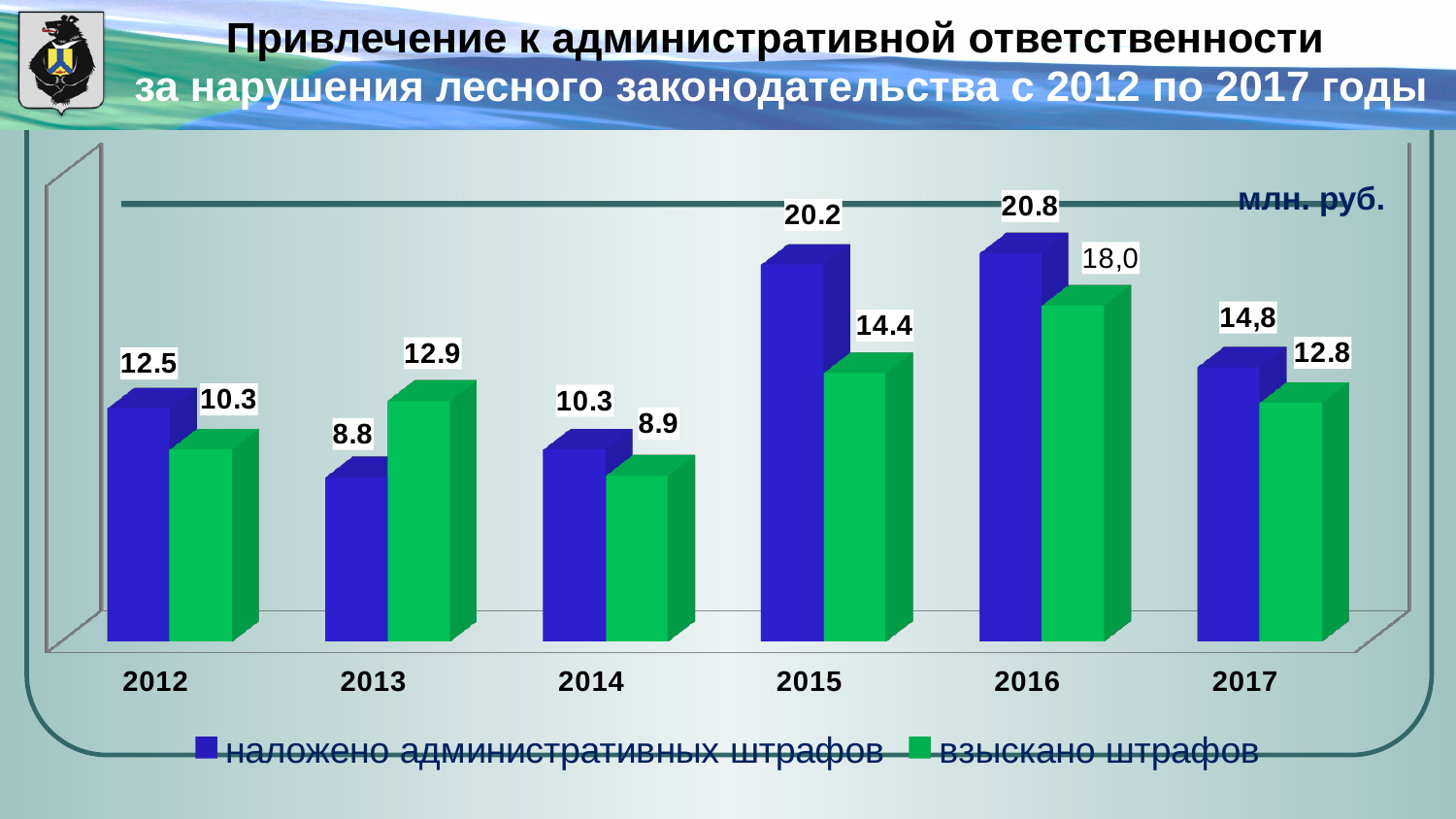
What is the value of "наложено административных штрафов" for 2015? 20.2 In 2013, which is larger: "наложено административных штрафов" or "взыскано штрафов"? взыскано штрафов What type of chart is shown on the slide? bar chart What is the value of "взыскано штрафов" for 2016? 18,0 In which year is "наложено административных штрафов" the highest? 2016 What is the value of "наложено административных штрафов" for 2017? 14,8 How many series does the legend list? 2 What unit is indicated on the chart? млн. руб. What is the value of "взыскано штрафов" for 2013? 12.9 What is the difference between "наложено административных штрафов" and "взыскано штрафов" in 2015? 5.8 In which year is "взыскано штрафов" the lowest? 2014 How many years are shown on the x axis? 6